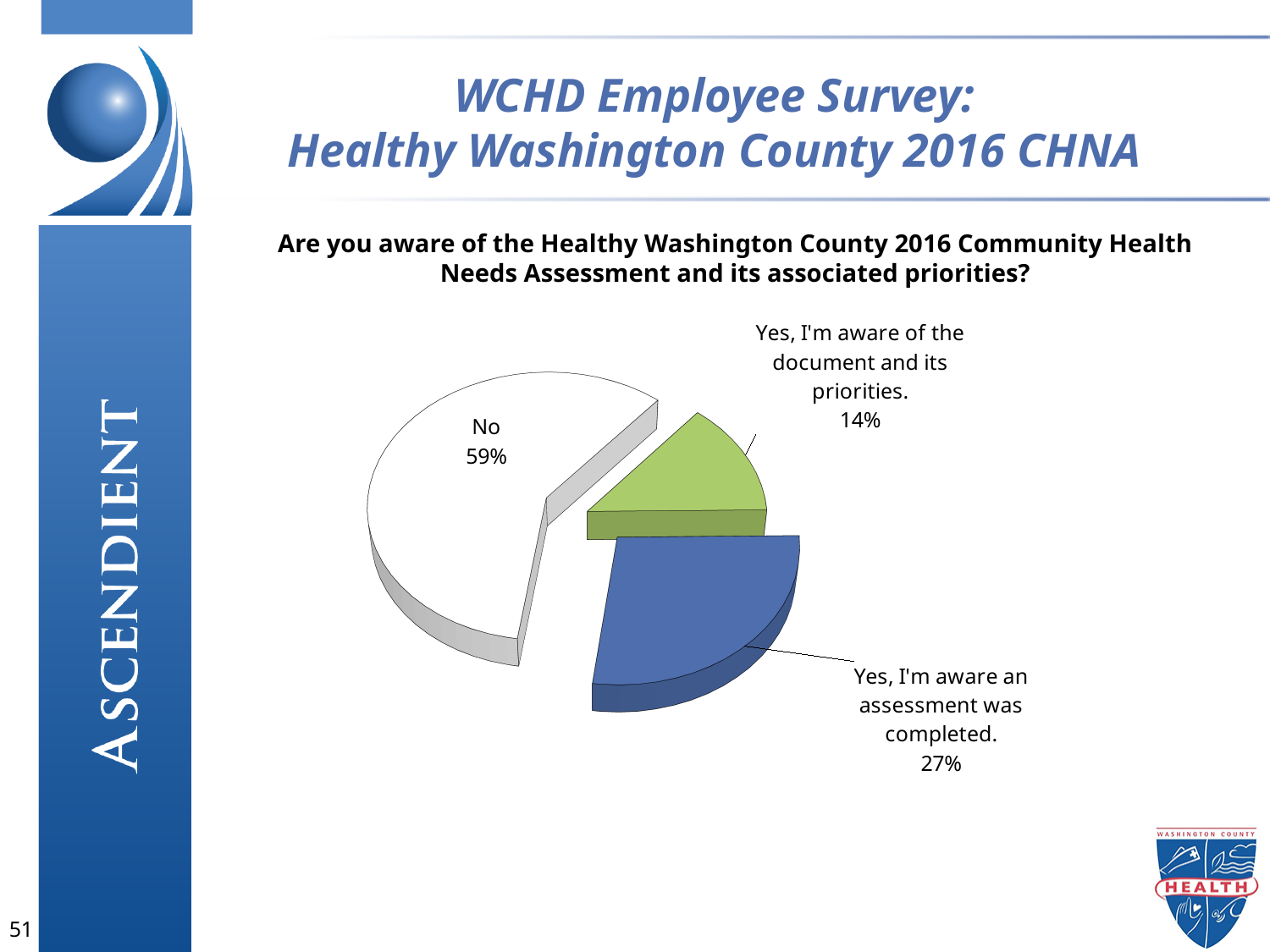
What percentage of respondents answered "No"? 59% Which response has the largest share of the pie? No What percentage of respondents said they are aware of the document and its priorities? 14% What is the difference in percentage points between the "No" slice and the "Yes, I'm aware an assessment was completed" slice? 32 What percentage of respondents said they are aware an assessment was completed? 27% Which response has the smallest share of the pie? Yes, I'm aware of the document and its priorities. What survey question does the pie chart answer? Are you aware of the Healthy Washington County 2016 Community Health Needs Assessment and its associated priorities? What is the difference in percentage points between the "Yes, I'm aware an assessment was completed" slice and the "Yes, I'm aware of the document and its priorities" slice? 13 Which is larger: the share for "Yes, I'm aware an assessment was completed" or the share for "Yes, I'm aware of the document and its priorities"? Yes, I'm aware an assessment was completed. What type of chart is shown on the slide? Pie chart What is the combined percentage of respondents who gave either "Yes" answer? 41% How many response categories are shown in the pie chart? 3